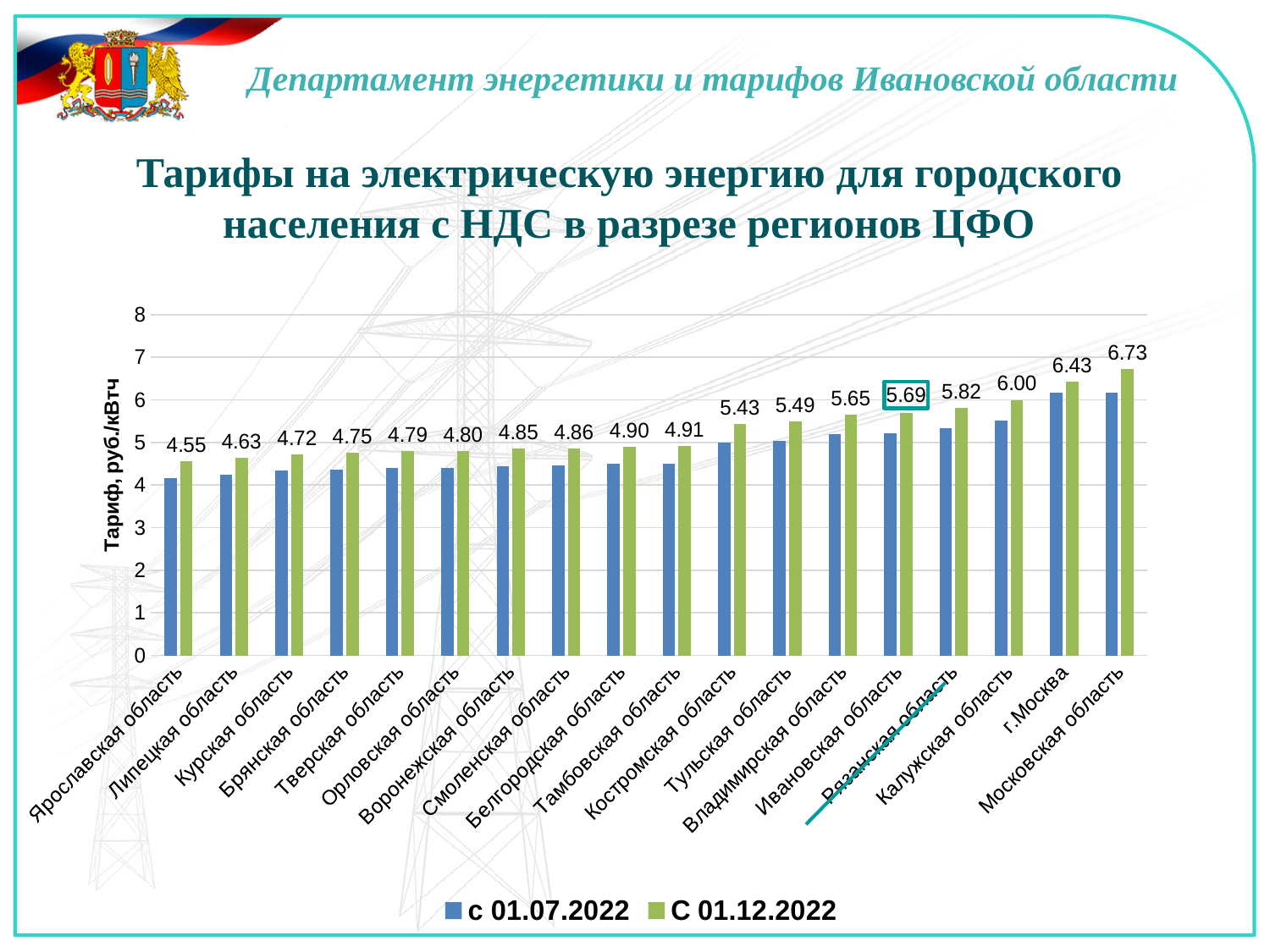
What is the value for Ивановская область in the С 01.12.2022 series? 5.69 What is the value for г.Москва in the С 01.12.2022 series? 6.43 What kind of chart is shown on the slide? bar chart Is the value for г.Москва in the с 01.07.2022 series greater or less than 6? greater How many series does the legend list? 2 In the С 01.12.2022 series, which is larger: Костромская область or Калужская область? Калужская область What is the difference between the С 01.12.2022 values for Московская область and Ярославская область? 2.18 Which region has the highest value in the С 01.12.2022 series? Московская область Do the С 01.12.2022 values rise or fall from left to right along the x axis? rise Which region has the lowest value in the С 01.12.2022 series? Ярославская область What is the label of the y axis? Тариф, руб./кВтч How many regions are shown on the x axis? 18